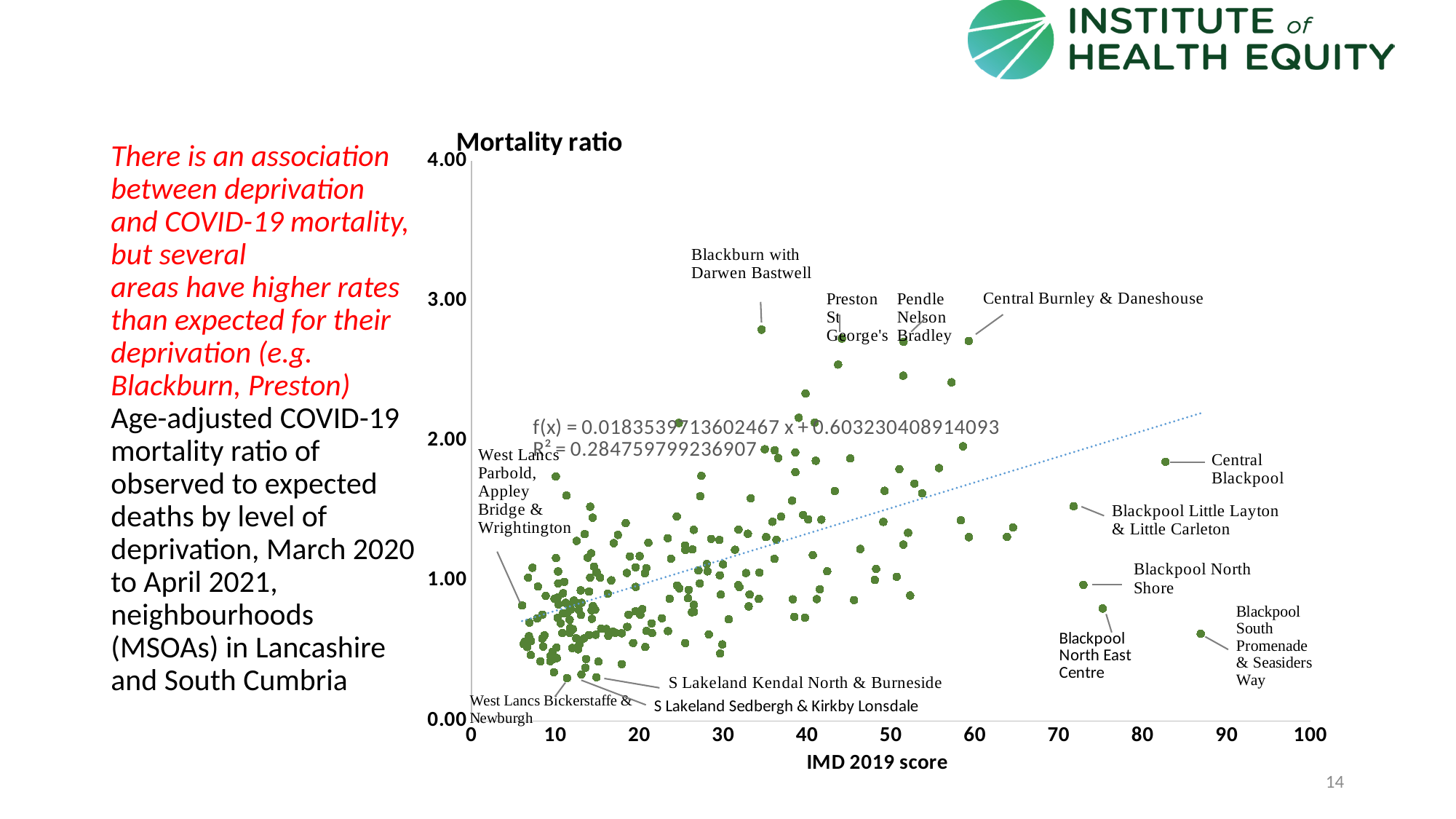
What is the label of the x axis? IMD 2019 score Does the fitted trend line rise or fall as the IMD 2019 score increases? rises Is the mortality ratio for Central Blackpool greater or less than 2.00? less Which has the higher mortality ratio, Central Blackpool or Blackpool North Shore? Central Blackpool Is the mortality ratio for Blackburn with Darwen Bastwell greater or less than 2.00? greater What R² value is printed on the chart for the trend line? 0.284759799236907 What is the title of the chart? Mortality ratio Is the mortality ratio for Central Burnley & Daneshouse greater or less than 2.00? greater What kind of chart is shown on the slide? Scatter plot Which has the higher mortality ratio, Blackburn with Darwen Bastwell or Central Blackpool? Blackburn with Darwen Bastwell